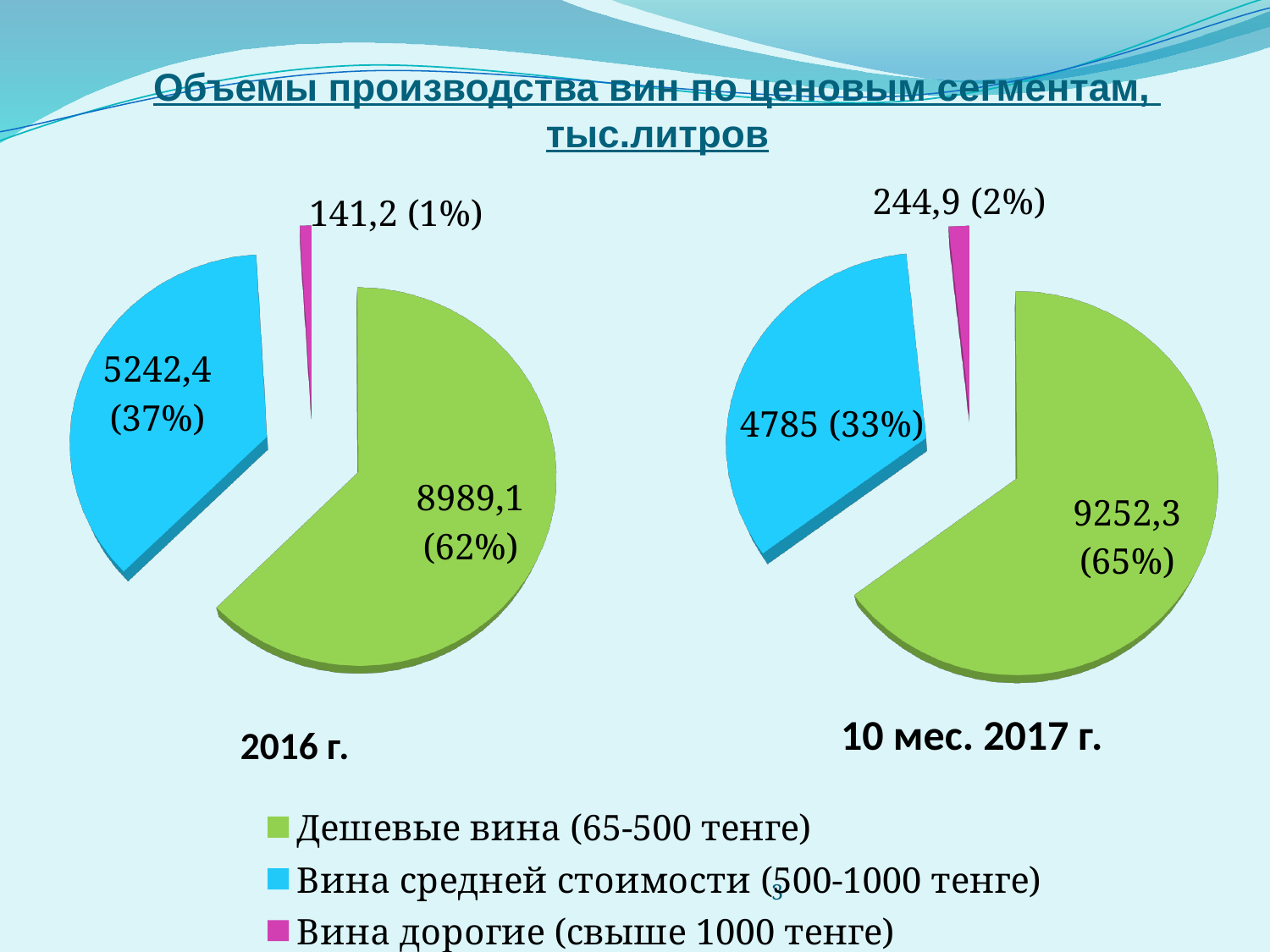
In the "10 мес. 2017 г." pie chart, what share of the pie does Дешевые вина (65-500 тенге) take? 65% In the "2016 г." pie chart, what is the value for Вина средней стоимости (500-1000 тенге)? 5242,4 In the "10 мес. 2017 г." pie chart, what is the value for Вина дорогие (свыше 1000 тенге)? 244,9 In the "10 мес. 2017 г." pie chart, what is the value for Вина средней стоимости (500-1000 тенге)? 4785 How many slices does the "2016 г." pie chart have? 3 In the "2016 г." pie chart, what share of the pie does Вина средней стоимости (500-1000 тенге) take? 37% In the "10 мес. 2017 г." pie chart, which is larger: Дешевые вина (65-500 тенге) or Вина средней стоимости (500-1000 тенге)? Дешевые вина (65-500 тенге) In the "2016 г." pie chart, what is the value for Дешевые вина (65-500 тенге)? 8989,1 In the "2016 г." pie chart, which category has the largest value? Дешевые вина (65-500 тенге) In the "10 мес. 2017 г." pie chart, which category has the smallest value? Вина дорогие (свыше 1000 тенге) What type of chart is used on this slide? Pie chart Which colour represents Вина дорогие (свыше 1000 тенге) in the legend? Pink